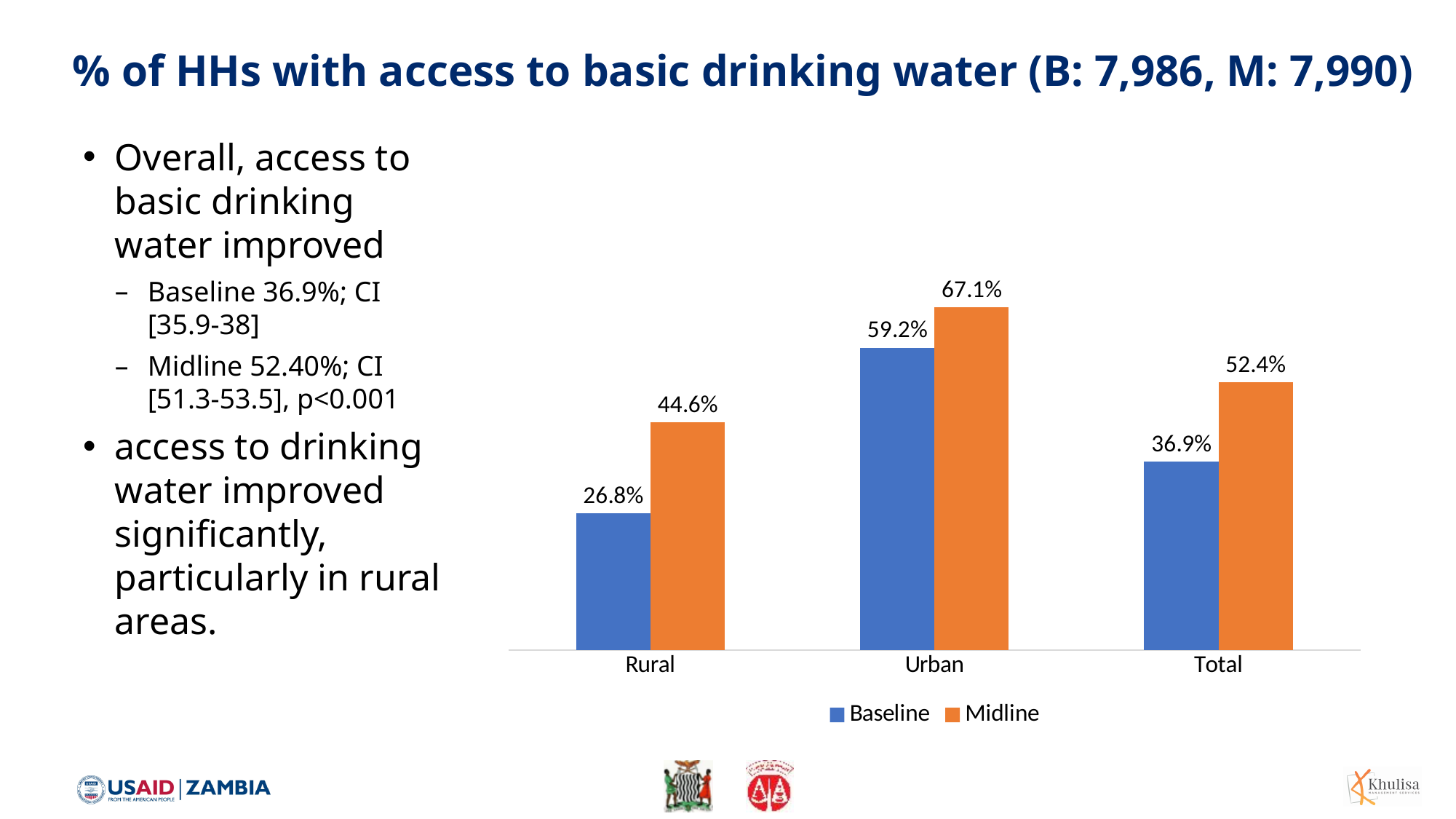
What kind of chart is shown on the slide? Bar chart Which colour represents the Midline series? Orange Which category has the highest Midline value? Urban What is the Baseline value for Rural? 26.8% Which category has the lowest Baseline value? Rural How many categories are shown on the x axis? 3 What is the difference between the Midline and Baseline values for Rural? 17.8% How many series does the legend list? 2 What is the Midline value for Total? 52.4% Which is larger, the Midline value for Rural or the Baseline value for Total? Midline value for Rural What is the Midline value for Urban? 67.1% What is the difference between the Urban and Rural Baseline values? 32.4%